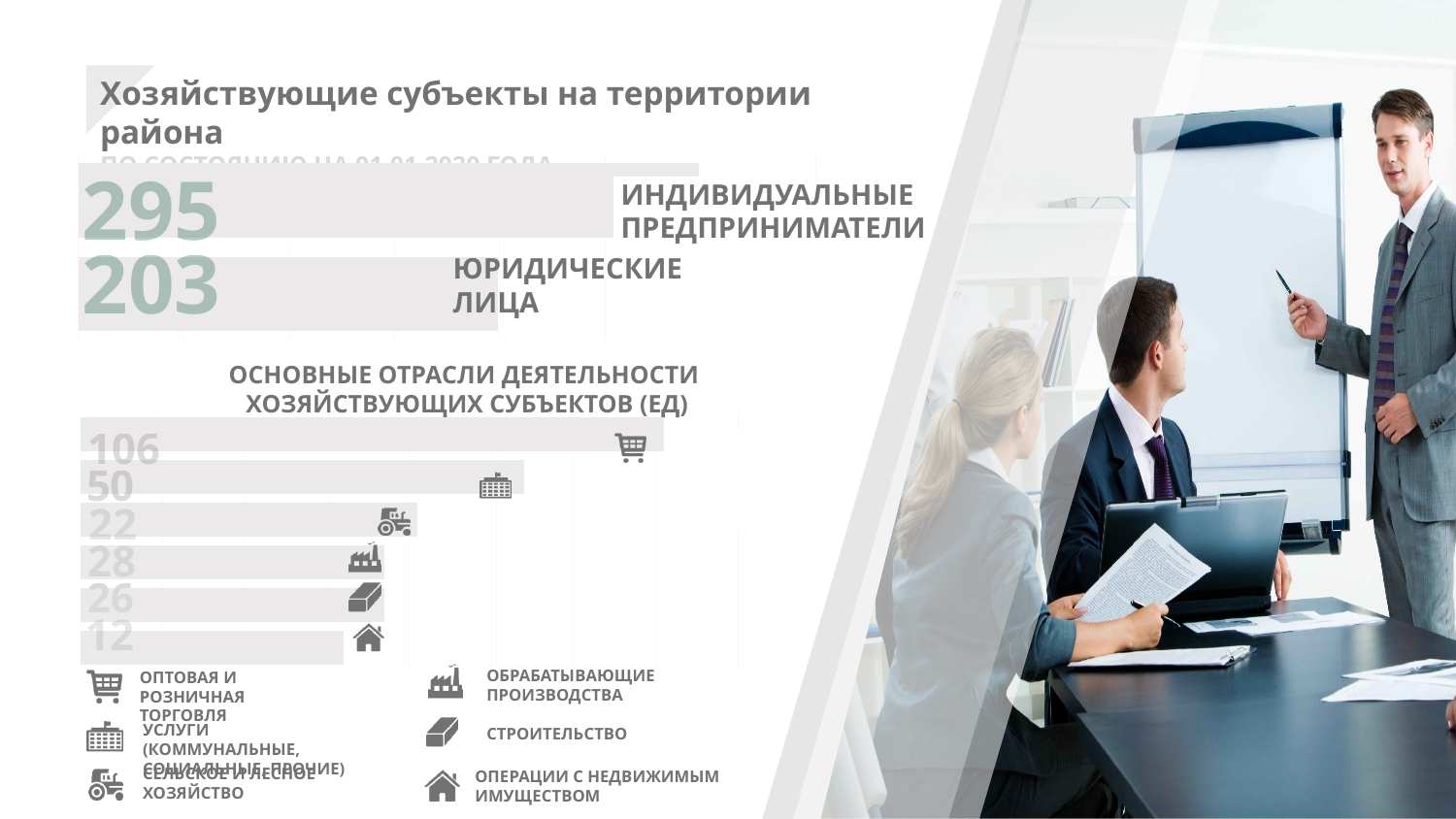
In the chart 'Основные отрасли деятельности хозяйствующих субъектов (ед)', what is the value for Услуги (коммунальные, социальные, прочие)? 50 In the chart 'Основные отрасли деятельности хозяйствующих субъектов (ед)', what is the value for Оптовая и розничная торговля? 106 In the chart 'Основные отрасли деятельности хозяйствующих субъектов (ед)', what is the value for Операции с недвижимым имуществом? 12 What kind of chart is 'Основные отрасли деятельности хозяйствующих субъектов (ед)'? Bar chart In the chart 'Основные отрасли деятельности хозяйствующих субъектов (ед)', what is the difference between Оптовая и розничная торговля and Услуги? 56 In the chart 'Основные отрасли деятельности хозяйствующих субъектов (ед)', which category has the lowest value? Операции с недвижимым имуществом In the chart 'Основные отрасли деятельности хозяйствующих субъектов (ед)', what is the value for Строительство? 26 In the chart 'Основные отрасли деятельности хозяйствующих субъектов (ед)', which category has the highest value? Оптовая и розничная торговля How many categories are shown in the chart 'Основные отрасли деятельности хозяйствующих субъектов (ед)'? 6 In the chart 'Основные отрасли деятельности хозяйствующих субъектов (ед)', which is larger: Обрабатывающие производства or Строительство? Обрабатывающие производства In the chart 'Основные отрасли деятельности хозяйствующих субъектов (ед)', what is the value for Обрабатывающие производства? 28 In the chart 'Основные отрасли деятельности хозяйствующих субъектов (ед)', what is the value for Сельское и лесное хозяйство? 22